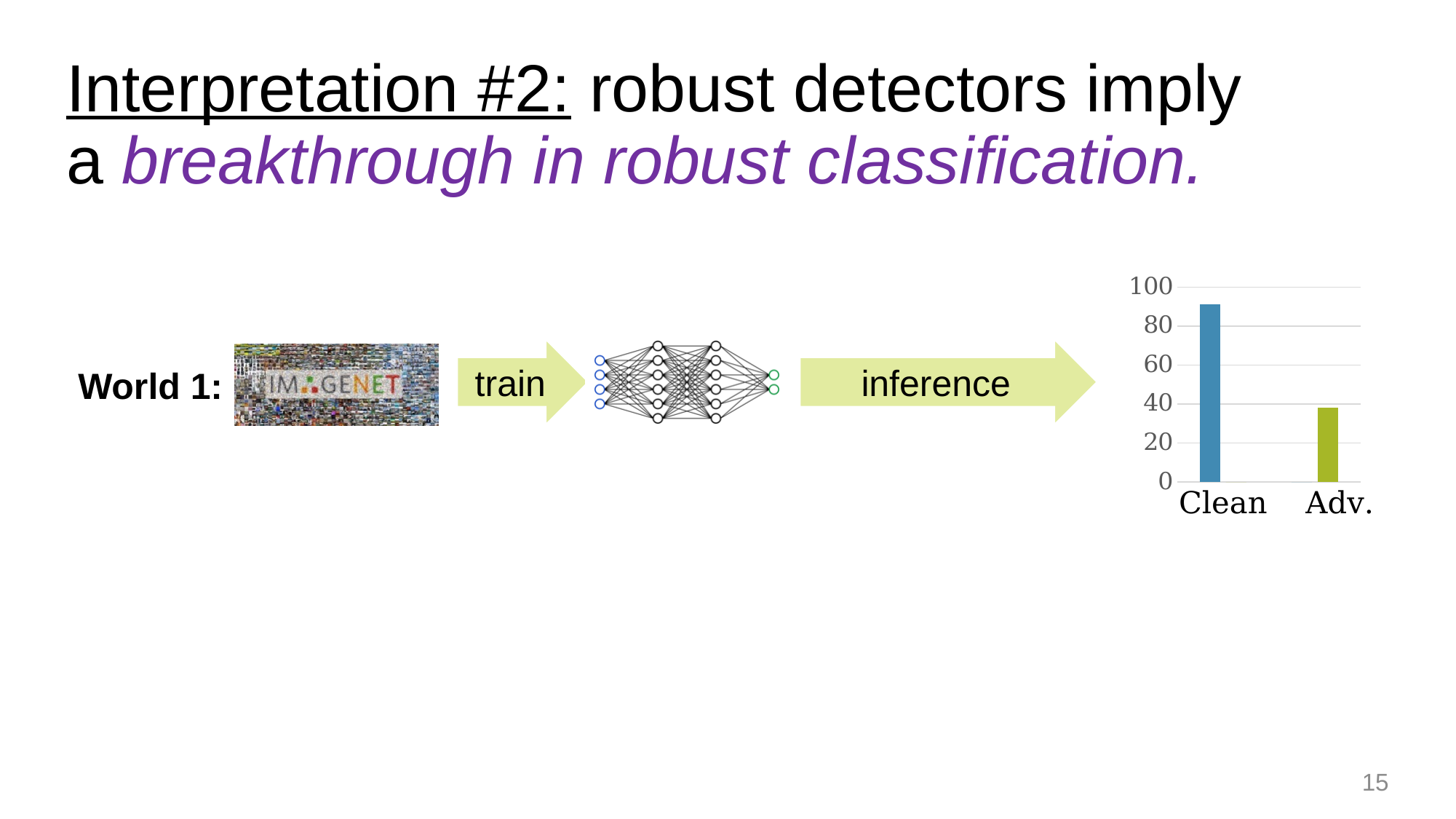
Is the value for Adv. greater or less than 20? greater What kind of chart is shown on the slide? bar chart Is the value for Clean greater or less than 80? greater Is the value for Adv. greater or less than 60? less Which category has the lowest bar in the chart? Adv. What is the highest tick value shown on the y axis of the chart? 100 What colour is the bar for Clean in the chart? blue How many categories are shown on the x axis of the bar chart? 2 Which is larger, the value for Clean or the value for Adv.? Clean Which category has the highest bar in the chart? Clean